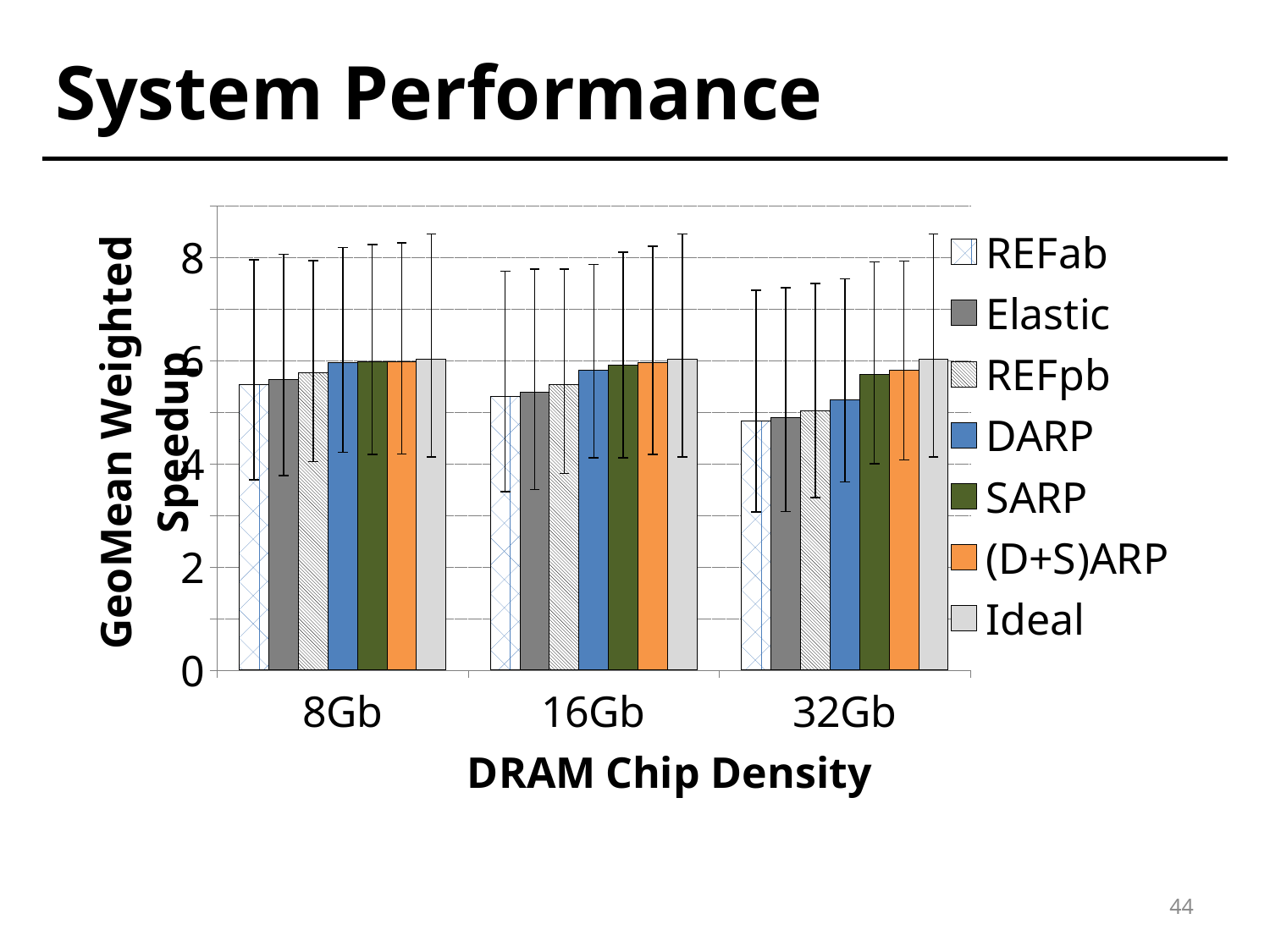
How many DRAM chip density categories are shown on the x axis? 3 Which is larger for REFab, the value at 8Gb or the value at 32Gb? 8Gb What kind of chart is shown on the slide? bar chart What is the label of the y axis? GeoMean Weighted Speedup Is the value for REFab at 32Gb greater or less than 4? greater What is the title of the x axis? DRAM Chip Density Is the value for DARP at 16Gb greater or less than 4? greater Do the REFab values rise or fall as DRAM chip density increases from 8Gb to 32Gb? fall Which is larger at 32Gb, the value for DARP or the value for SARP? SARP How many series does the legend list? 7 Is the value for SARP at 32Gb greater or less than 6? less